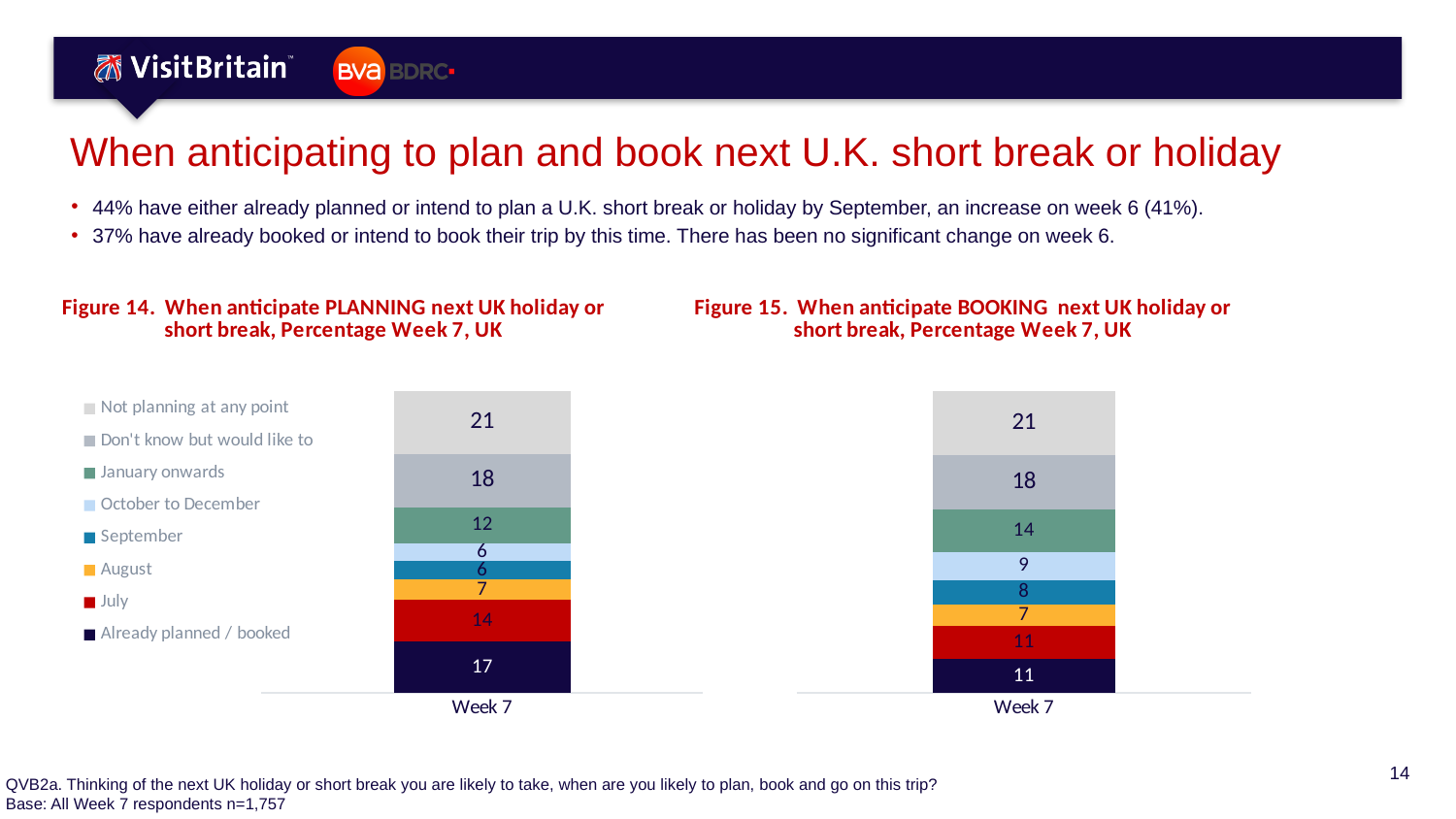
In Figure 15 (When anticipate BOOKING), which segment has the smallest value? August In Figure 15 (When anticipate BOOKING), what is the value for 'January onwards' in Week 7? 14 How many entries does the legend list for the charts on this slide? 8 Which is larger: 'September' in Figure 14 (PLANNING) or 'September' in Figure 15 (BOOKING)? Figure 15 (BOOKING) How many segments make up the stacked bar in Figure 15 (When anticipate BOOKING)? 8 In Figure 14 (When anticipate PLANNING), what is the value for 'July'? 14 In Figure 14 (When anticipate PLANNING), what is the difference between 'Not planning at any point' and 'Already planned / booked'? 4 What type of chart is Figure 14 (When anticipate PLANNING)? Stacked bar chart In Figure 14 (When anticipate PLANNING), which segment has the largest value? Not planning at any point In Figure 15 (When anticipate BOOKING), what is the value for 'October to December'? 9 In Figure 14 (When anticipate PLANNING), what is the value for 'Already planned / booked' in Week 7? 17 In Figure 15 (When anticipate BOOKING), what is the total of all segments in the Week 7 bar? 99